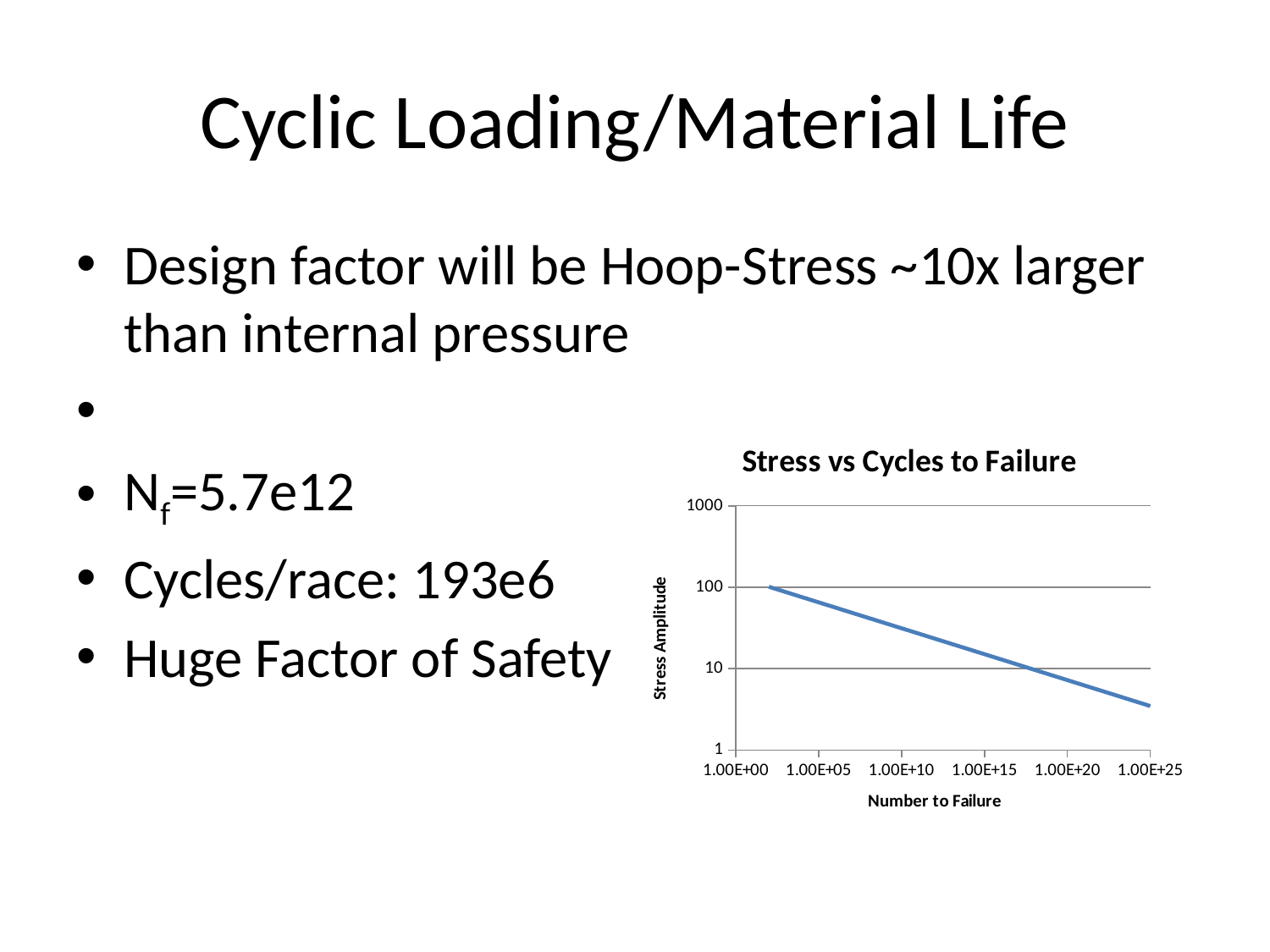
Is the stress amplitude at a number to failure of 1.00E+20 greater or less than 10? less Which end of the line has the higher stress amplitude, the left end or the right end? left end What kind of chart is shown on the slide? line chart What is the label of the x axis of the chart? Number to Failure Is the stress amplitude at a number to failure of 1.00E+10 greater or less than 100? less Is the stress amplitude at a number to failure of 1.00E+10 greater or less than 10? greater What is the highest value labelled on the y axis of the chart? 1000 Does the stress amplitude rise or fall as the number to failure increases along the x axis? fall How many tick labels are shown on the x axis of the chart? 6 What is the title of the chart? Stress vs Cycles to Failure